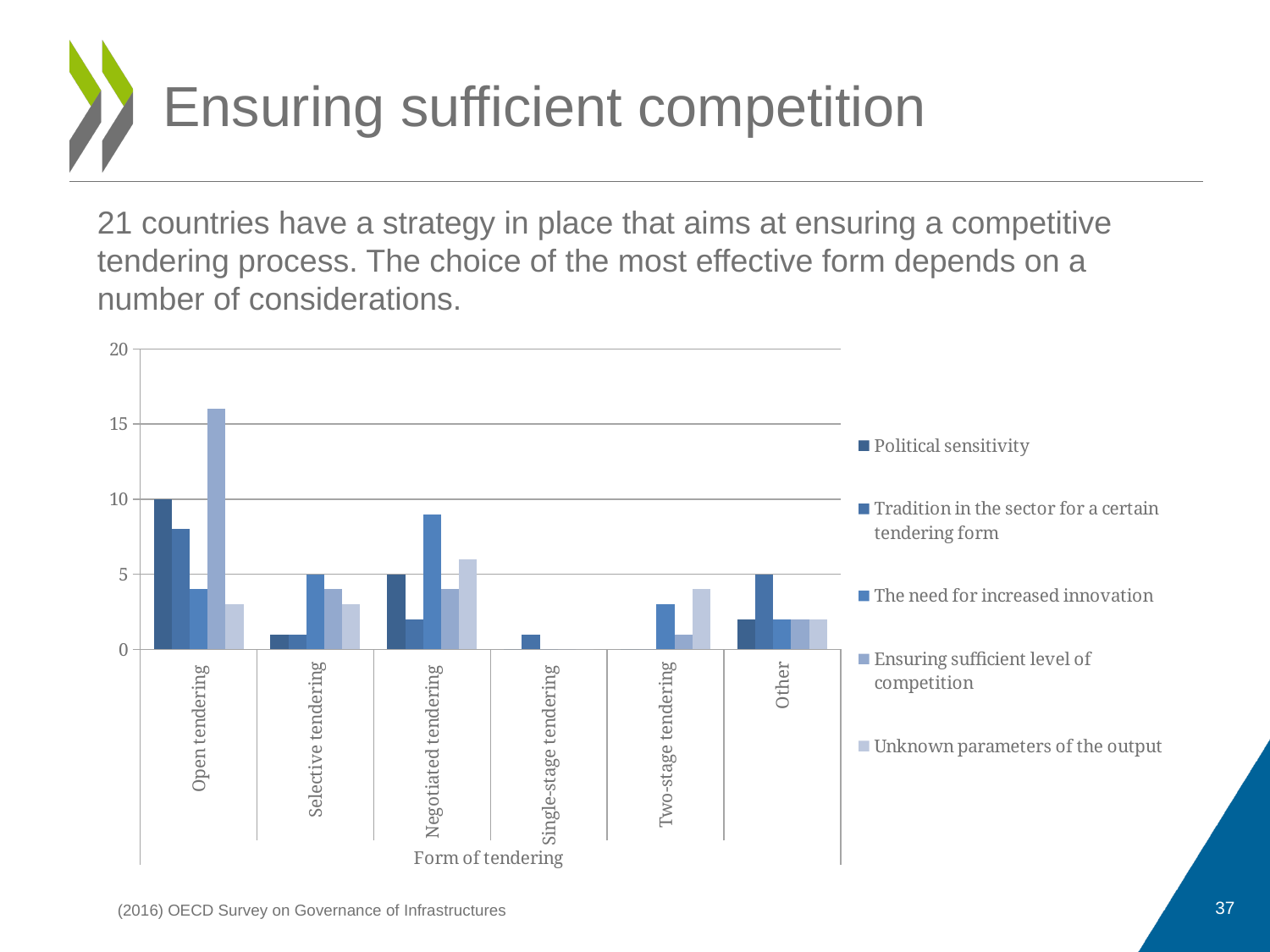
What is the value for Political sensitivity under Open tendering? 10 How many series does the legend list? 5 Which form of tendering has the tallest bar for Ensuring sufficient level of competition? Open tendering What is the value for Tradition in the sector for a certain tendering form under Other? 5 What kind of chart is shown on the slide? bar chart Under Open tendering, which is larger: Ensuring sufficient level of competition or Political sensitivity? Ensuring sufficient level of competition What is the title of the slide containing the chart? Ensuring sufficient competition How many forms of tendering are shown on the x axis? 6 Is the value for The need for increased innovation under Negotiated tendering greater or less than 10? less Is the value for Ensuring sufficient level of competition under Open tendering greater or less than 15? greater What is the value for The need for increased innovation under Selective tendering? 5 What is the label of the x axis? Form of tendering